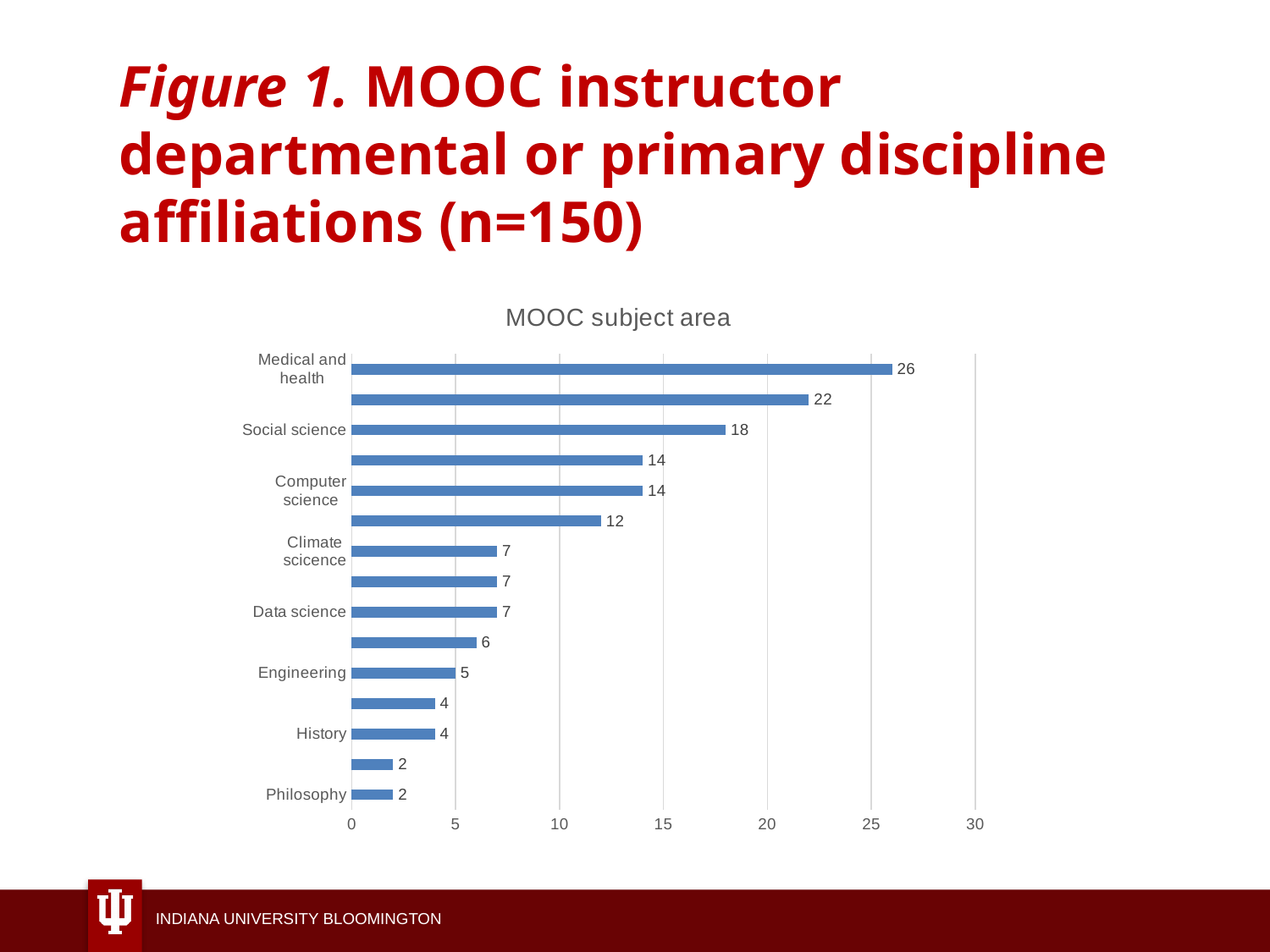
What is the difference between the values for Medical and health and Social science? 8 What is the value for Philosophy? 2 Which is larger, the value for Social science or the value for Computer science? Social science What kind of chart is shown on the slide? Bar chart What is the value for Social science? 18 Do the bars get longer or shorter going from the top of the chart to the bottom? Shorter What is the value for Computer science? 14 What is the title of the chart? MOOC subject area How many bars are plotted in the chart? 15 What is the value for Engineering? 5 Which category has the highest value? Medical and health What is the value for Medical and health? 26